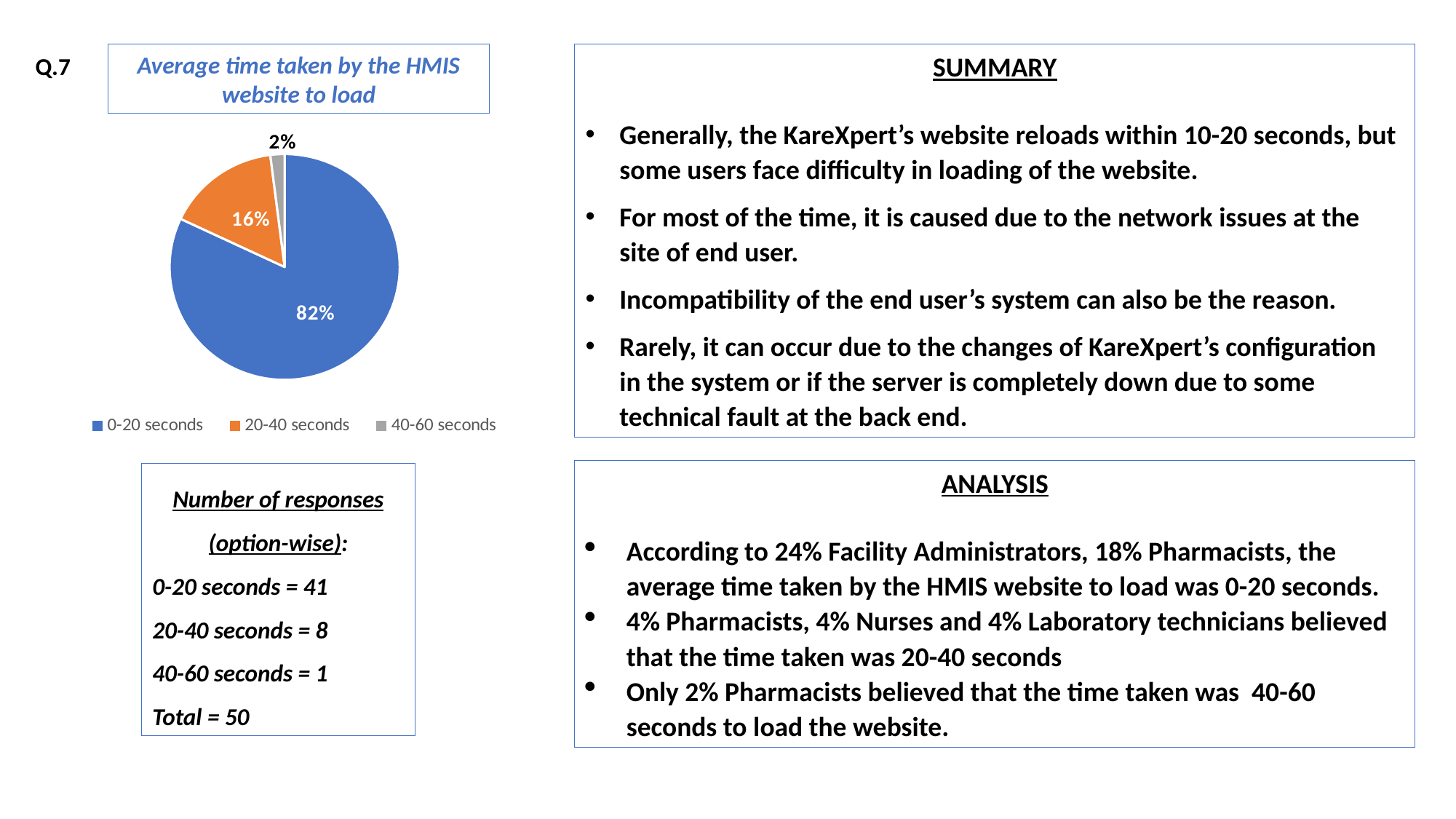
Is the share for 0-20 seconds greater or less than 50%? greater What colour is the 20-40 seconds slice in the pie chart? orange Which category has the largest slice of the pie? 0-20 seconds Which category has the smallest slice of the pie? 40-60 seconds What share of the pie does the 20-40 seconds slice represent? 16% What is the title of the pie chart? Average time taken by the HMIS website to load What is the difference in percentage points between the 0-20 seconds slice and the 20-40 seconds slice? 66 What share of the pie does the 40-60 seconds slice represent? 2% What kind of chart is shown on the slide? pie chart Which slice is larger, 20-40 seconds or 40-60 seconds? 20-40 seconds How many categories does the pie chart show? 3 What share of the pie does the 0-20 seconds slice represent? 82%